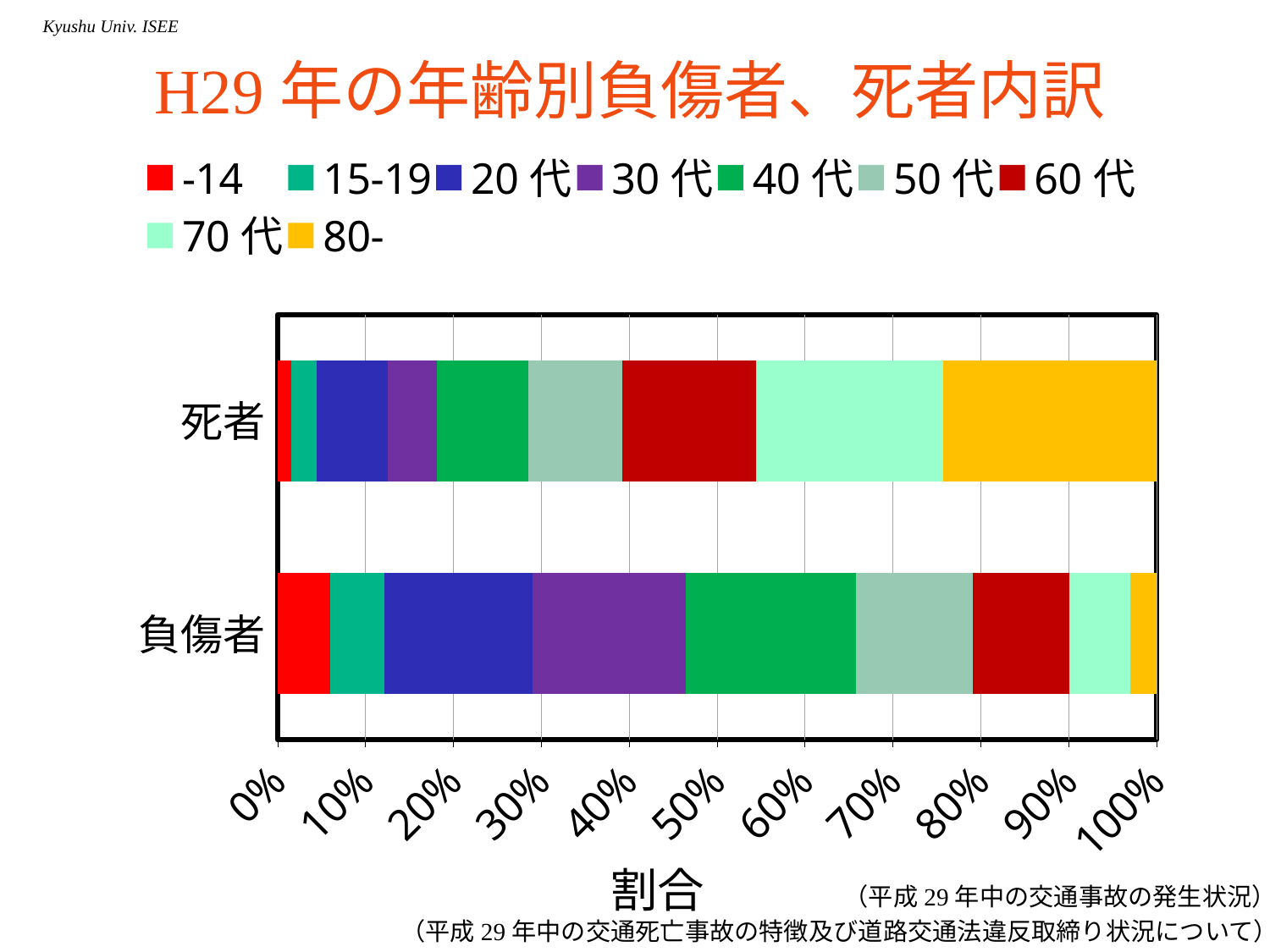
What is the label of the horizontal axis? 割合 Is the share of the 80- group in the 死者 bar greater or less than 20%? greater Is the share of the -14 group in the 死者 bar greater or less than 10%? less Is the share of the 30代 group in the 負傷者 bar greater or less than 10%? greater What kind of chart is shown on the slide? stacked bar chart Which bar has the larger share for the 80- group, 死者 or 負傷者? 死者 How many categories (bars) does the chart show? 2 Which age group has the smallest share in the 死者 bar? -14 How many series does the legend list? 9 What is the title of the chart on the slide? H29年の年齢別負傷者、死者内訳 What do the segments of each bar add up to? 100%